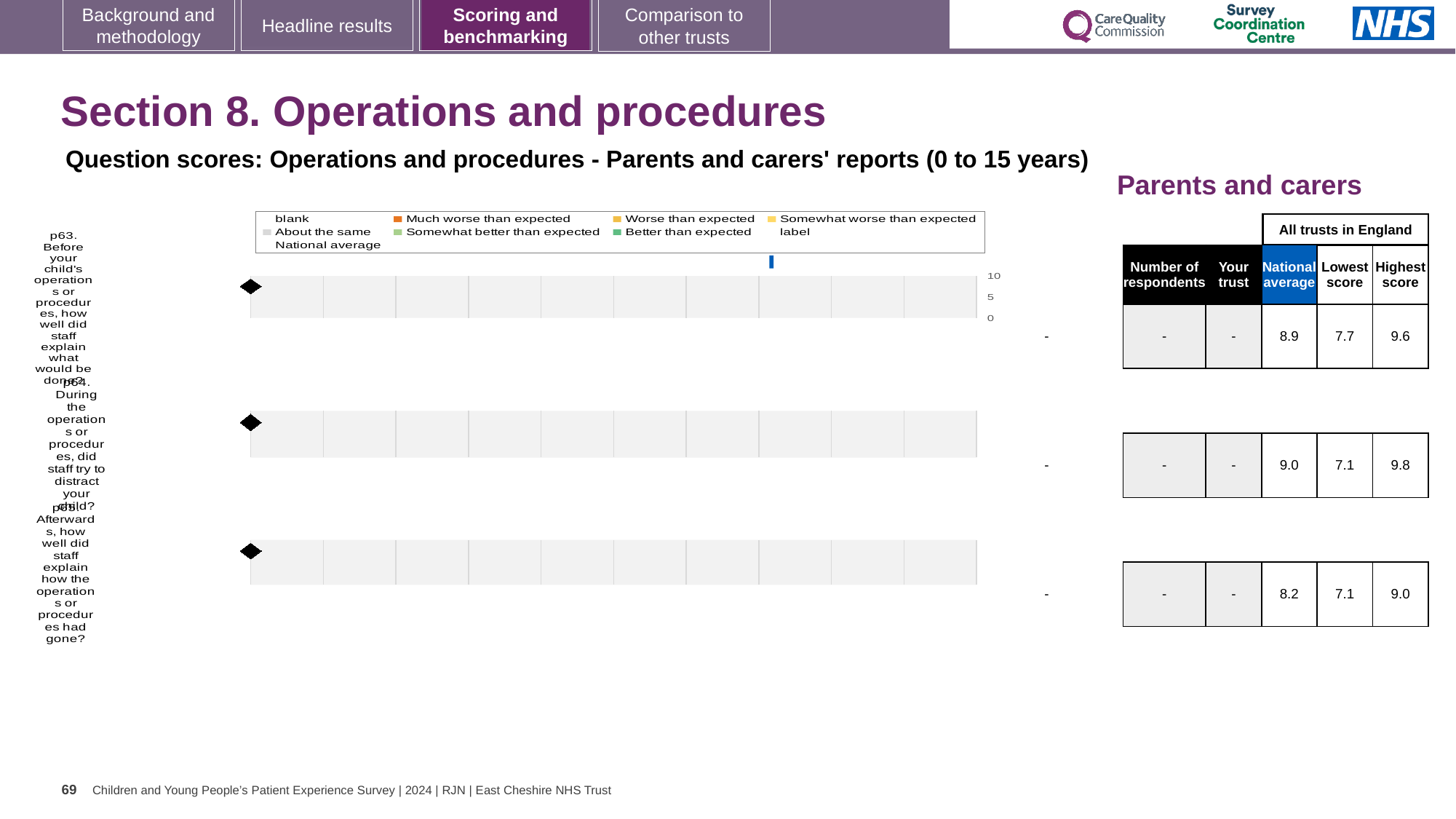
In the table, what is the highest score across all trusts in England for p64 (During the operations or procedures, did staff try to distract your child)? 9.8 What is the difference between the highest score and the lowest score for p63 in the table? 1.9 Is the national average for p65 larger or smaller than the national average for p63? smaller What kind of chart is shown on the slide? bar chart Which question has the highest national average score in the table? p64 Which question has the lowest national average score in the table? p65 In the table, what is the lowest score across all trusts in England for p65 (Afterwards, how well did staff explain how the operations or procedures had gone)? 7.1 In the table, what is shown as the 'Your trust' score for p63? - How many questions (categories) are listed on the chart's vertical axis? 3 What is the highest value shown on the chart's numeric axis? 10 Which colour does the legend use for 'Much worse than expected'? orange In the table, what is the national average score for p63 (Before your child's operations or procedures, how well did staff explain what would be done)? 8.9